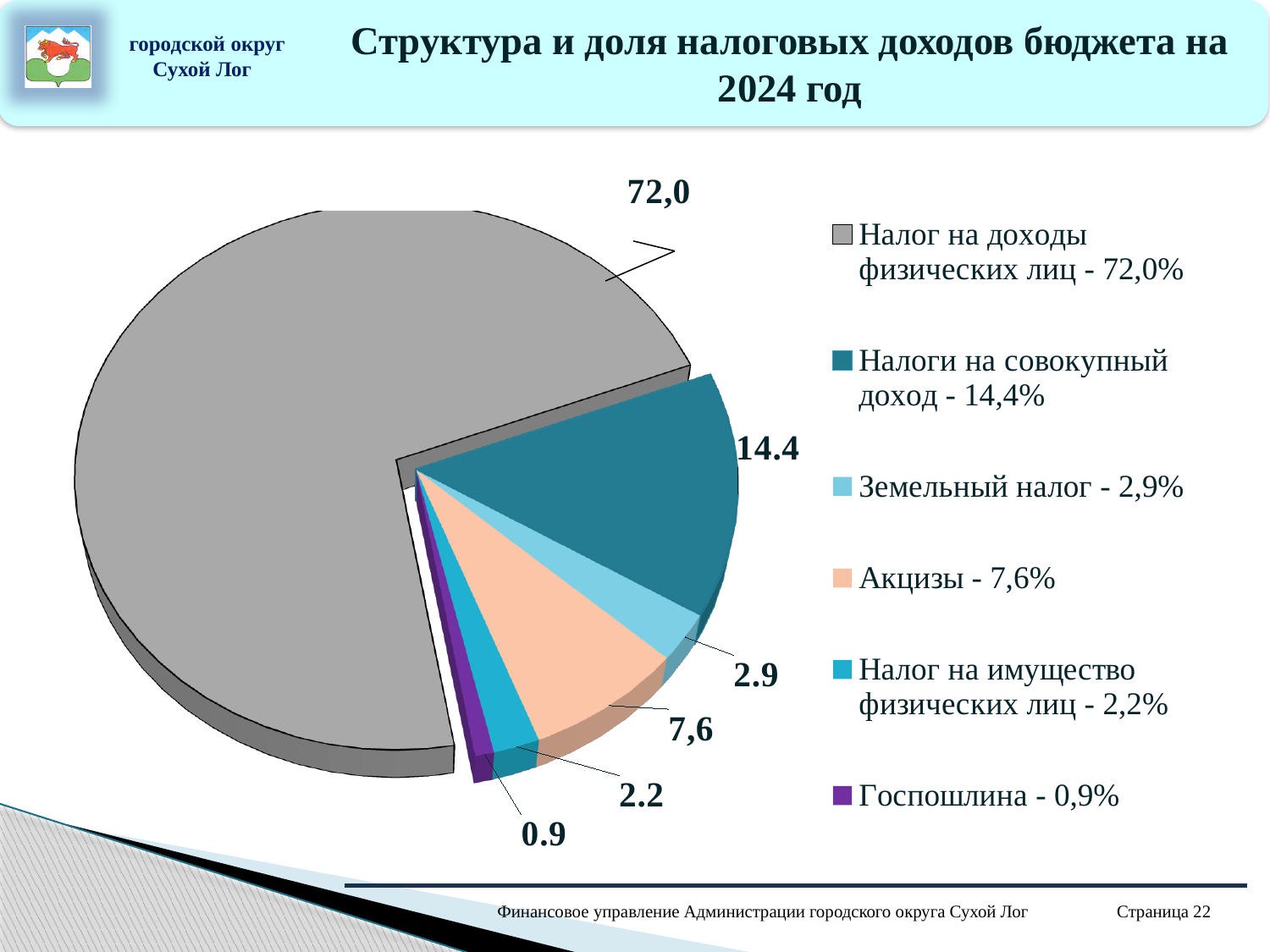
What is the difference in percentage points between 'Акцизы' and 'Земельный налог'? 4,7 What is the difference in percentage points between 'Налог на доходы физических лиц' and 'Налоги на совокупный доход'? 57,6 What kind of chart is shown on the slide? Pie chart What is the share of 'Земельный налог'? 2,9% What is the share of 'Налоги на совокупный доход'? 14,4% What share of tax revenues does 'Налог на доходы физических лиц' account for? 72,0% Which category has the smallest slice of the pie? Госпошлина What is the title of the chart on the slide? Структура и доля налоговых доходов бюджета на 2024 год Which category has the largest slice of the pie? Налог на доходы физических лиц What is the share of 'Акцизы'? 7,6% How many categories are shown in the pie chart? 6 Which is larger: the share of 'Акцизы' or the share of 'Земельный налог'? Акцизы